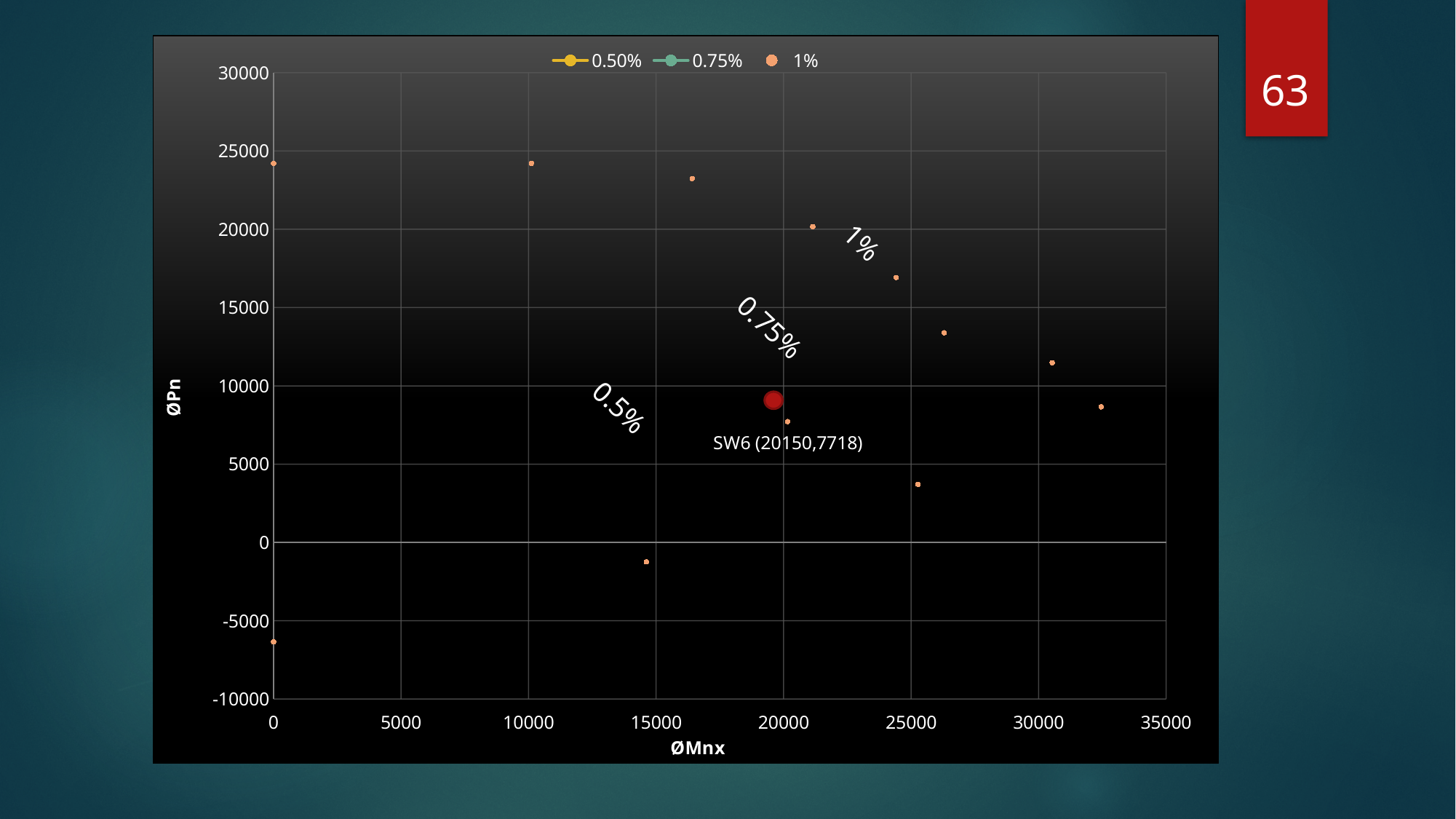
What is the ØPn value of the point labelled SW6? 7718 Is the ØPn value of the point at ØMnx = 0 near the top of the chart greater or less than 20000? greater Is the ØPn value of the point at roughly ØMnx = 32500 greater or less than 10000? less What is the label of the horizontal axis? ØMnx What are the coordinates printed for the point labelled SW6? (20150,7718) What is the highest value shown on the ØPn axis? 30000 How many series does the legend list? 3 What is the ØMnx value of the point labelled SW6? 20150 What kind of chart is shown on the slide? scatter chart What is the label of the vertical axis? ØPn Is the ØPn value of the lowest point at ØMnx = 0 greater or less than -5000? less